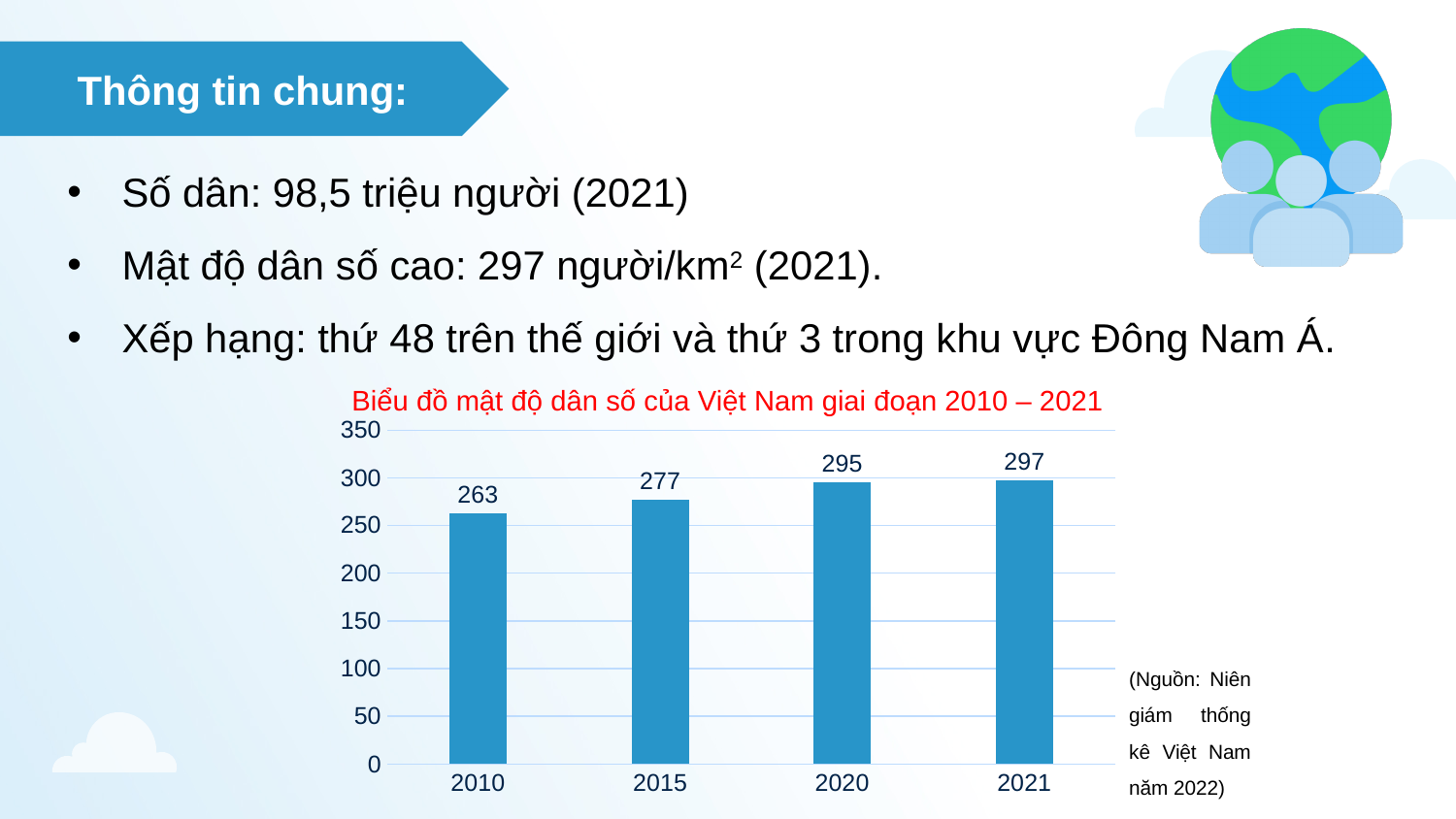
What is the value shown for 2020? 295 What is the population density value shown for 2010? 263 What is the difference between the values for 2020 and 2015? 18 What is the value shown for 2021? 297 Which year has the lowest value in the chart? 2010 What is the difference between the values for 2021 and 2010? 34 What is the value shown for 2015? 277 Do the values rise or fall from 2010 to 2021? Rise Which is larger, the value for 2015 or the value for 2020? 2020 How many years are shown on the x axis of the chart? 4 What kind of chart is shown on the slide? Bar chart Which year has the highest value in the chart? 2021